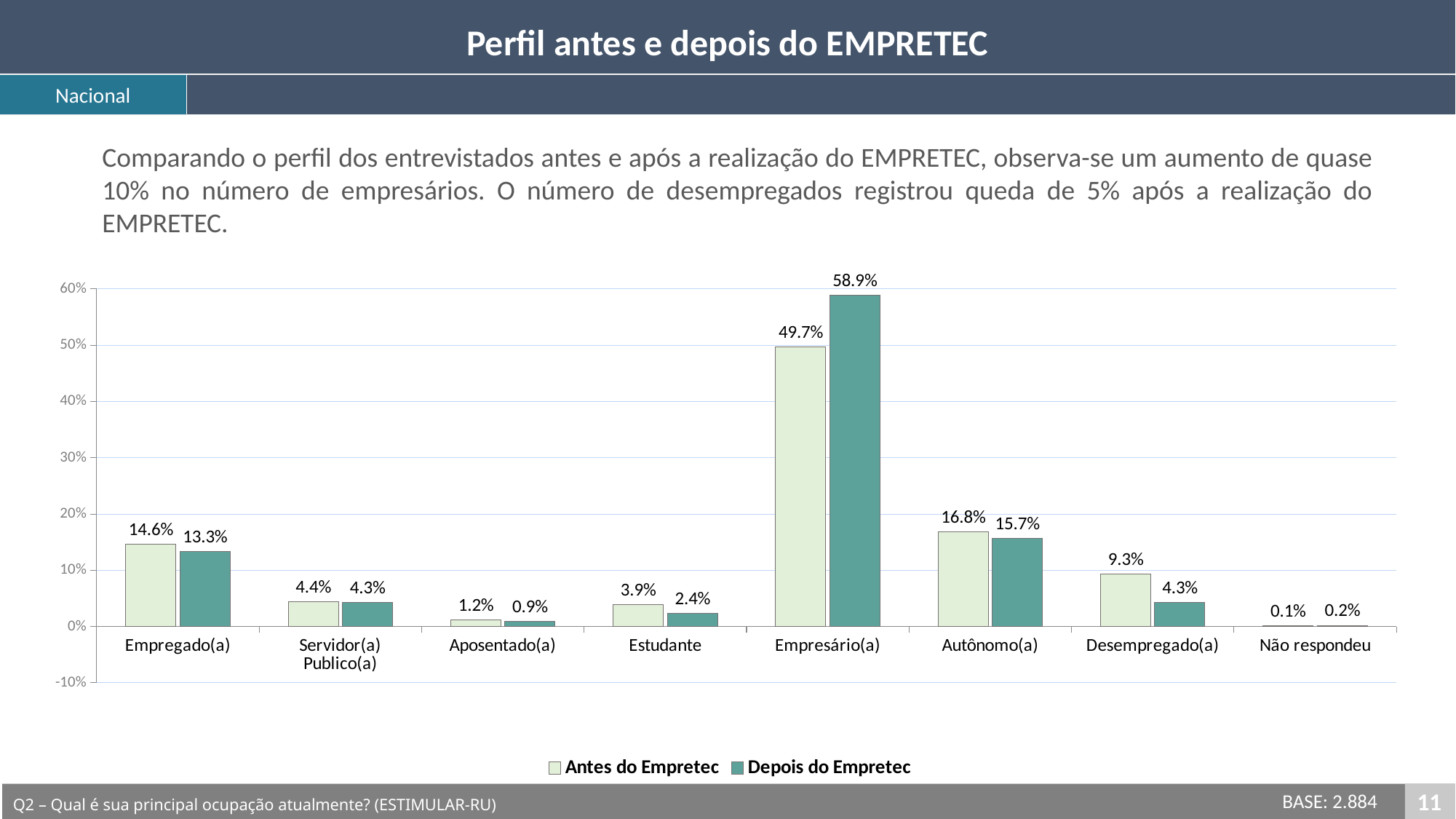
Is the Depois do Empretec value for Empregado(a) greater or less than 20%? less What is the value for Estudante in the Depois do Empretec series? 2.4% How many series does the legend list? 2 For Autônomo(a), which series has the larger value, Antes do Empretec or Depois do Empretec? Antes do Empretec What is the difference between the Depois do Empretec and Antes do Empretec values for Empresário(a)? 9.2% Which category has the highest value in the Antes do Empretec series? Empresário(a) How many categories are shown on the x axis? 8 Which category has the lowest value in the Depois do Empretec series? Não respondeu What is the value for Desempregado(a) in the Antes do Empretec series? 9.3% What kind of chart is shown on the slide? bar chart What is the value for Empresário(a) in the Depois do Empretec series? 58.9% What is the difference between the Antes do Empretec and Depois do Empretec values for Desempregado(a)? 5.0%